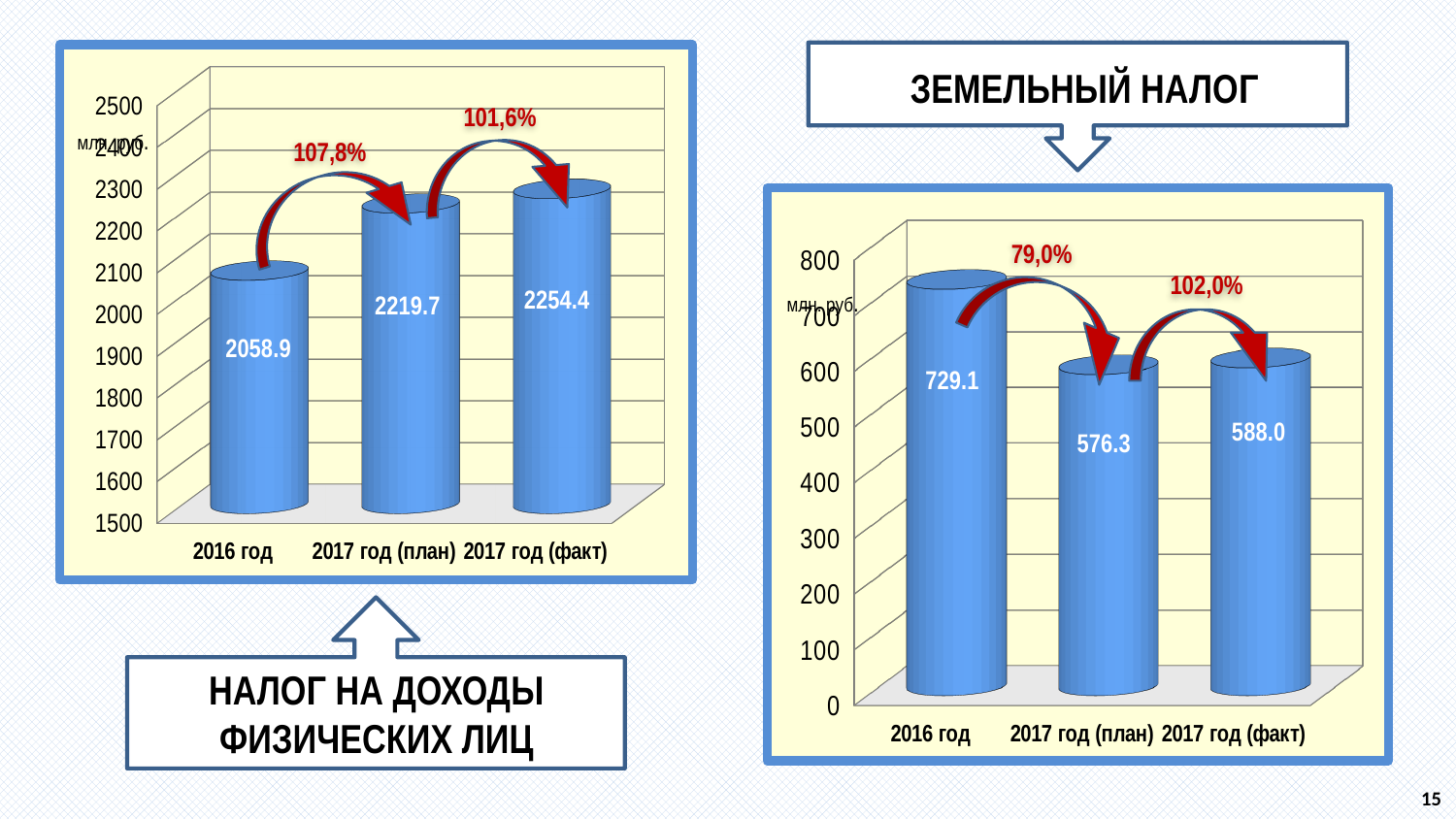
In the chart for ЗЕМЕЛЬНЫЙ НАЛОГ, what is the value for 2017 год (факт)? 588.0 In the chart for НАЛОГ НА ДОХОДЫ ФИЗИЧЕСКИХ ЛИЦ, do the values rise or fall from 2016 год to 2017 год (факт)? rise In the chart for ЗЕМЕЛЬНЫЙ НАЛОГ, which is larger: 2017 год (план) or 2017 год (факт)? 2017 год (факт) In the chart for ЗЕМЕЛЬНЫЙ НАЛОГ, which category has the lowest value? 2017 год (план) In the chart for НАЛОГ НА ДОХОДЫ ФИЗИЧЕСКИХ ЛИЦ, what is the difference between 2017 год (план) and 2016 год? 160.8 In the chart for НАЛОГ НА ДОХОДЫ ФИЗИЧЕСКИХ ЛИЦ, what is the value for 2017 год (план)? 2219.7 In the chart for ЗЕМЕЛЬНЫЙ НАЛОГ, what is the difference between 2016 год and 2017 год (план)? 152.8 In the chart for НАЛОГ НА ДОХОДЫ ФИЗИЧЕСКИХ ЛИЦ, what is the value for 2016 год? 2058.9 In the chart for ЗЕМЕЛЬНЫЙ НАЛОГ, what is the value for 2016 год? 729.1 In the chart for НАЛОГ НА ДОХОДЫ ФИЗИЧЕСКИХ ЛИЦ, which category has the highest value? 2017 год (факт) How many categories are shown in the chart for ЗЕМЕЛЬНЫЙ НАЛОГ? 3 What kind of chart is used for НАЛОГ НА ДОХОДЫ ФИЗИЧЕСКИХ ЛИЦ? bar chart